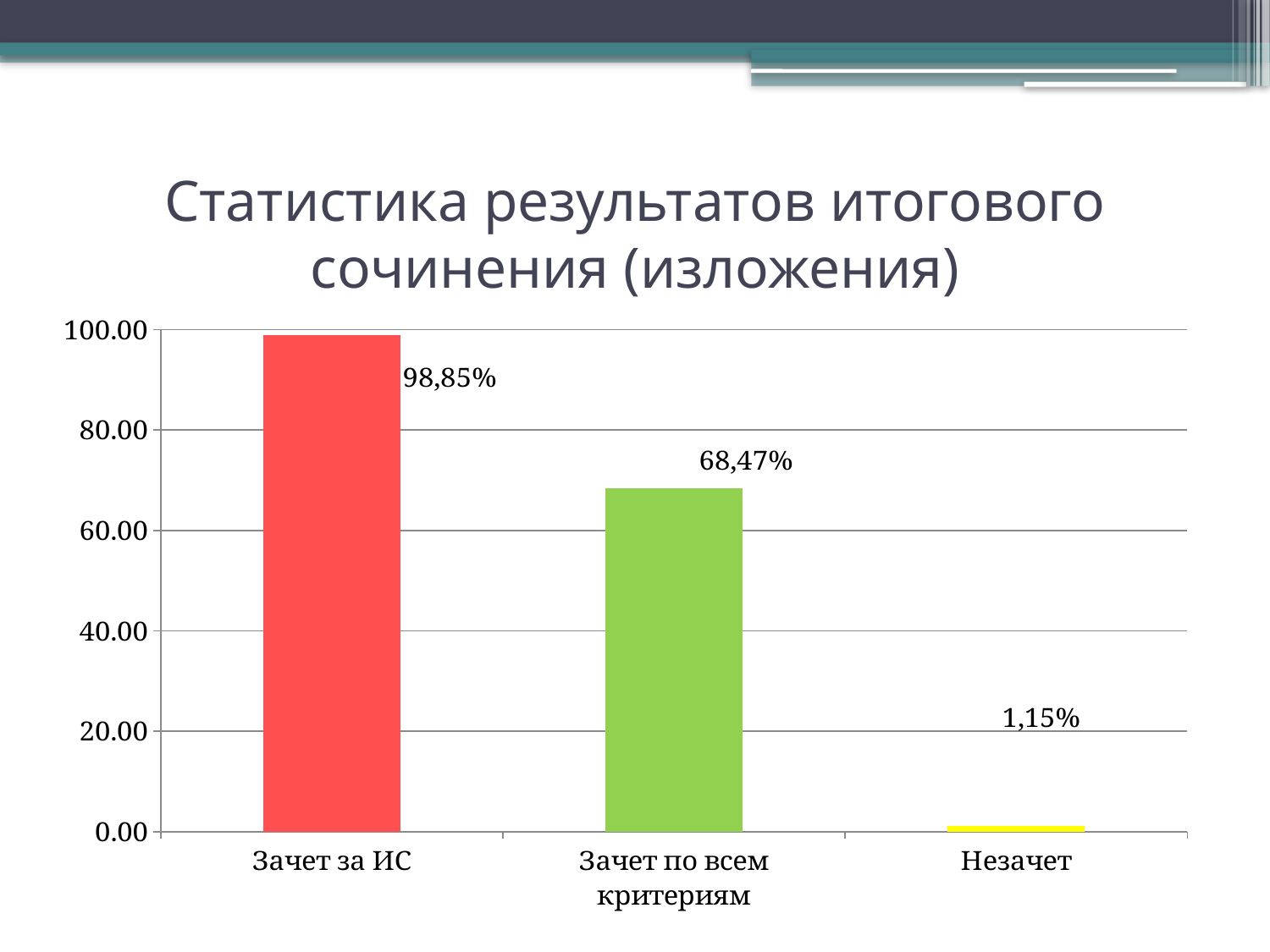
Which is larger, the value for Зачет за ИС or the value for Зачет по всем критериям? Зачет за ИС What is the difference between the values for Зачет по всем критериям and Незачет? 67,32% What is the value for Зачет за ИС? 98,85% Which category has the lowest value? Незачет Is the value for Зачет по всем критериям greater or less than 60.00? greater What is the difference between the values for Зачет за ИС and Зачет по всем критериям? 30,38% How many categories are shown on the chart? 3 What is the value for Незачет? 1,15% Which category has the highest value? Зачет за ИС What is the title of the slide? Статистика результатов итогового сочинения (изложения) What is the value for Зачет по всем критериям? 68,47% What kind of chart is shown on the slide? bar chart